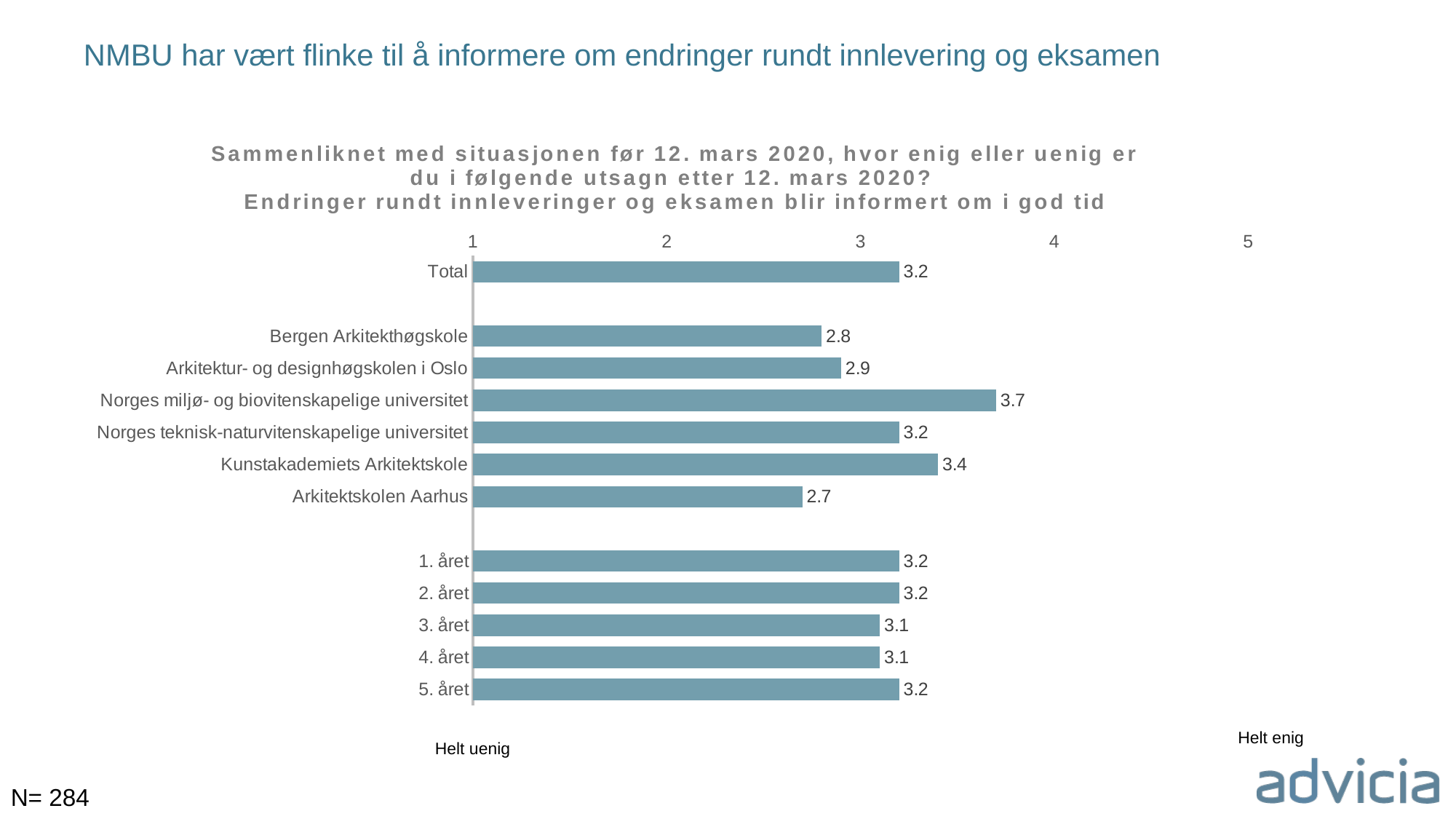
Which category has the lowest value? Arkitektskolen Aarhus What is the value for 3. året? 3.1 What is the value for Arkitektskolen Aarhus? 2.7 What is the sample size (N) shown on the slide? 284 What is the value for Total? 3.2 What is the value for Norges miljø- og biovitenskapelige universitet? 3.7 What is the difference between the values for Norges miljø- og biovitenskapelige universitet and Bergen Arkitekthøgskole? 0.9 How many categories are plotted in the chart? 12 Is the value for Bergen Arkitekthøgskole greater or less than 3? less Which is larger, the value for Kunstakademiets Arkitektskole or the value for Arkitektur- og designhøgskolen i Oslo? Kunstakademiets Arkitektskole Which category has the highest value? Norges miljø- og biovitenskapelige universitet What kind of chart is shown on the slide? bar chart